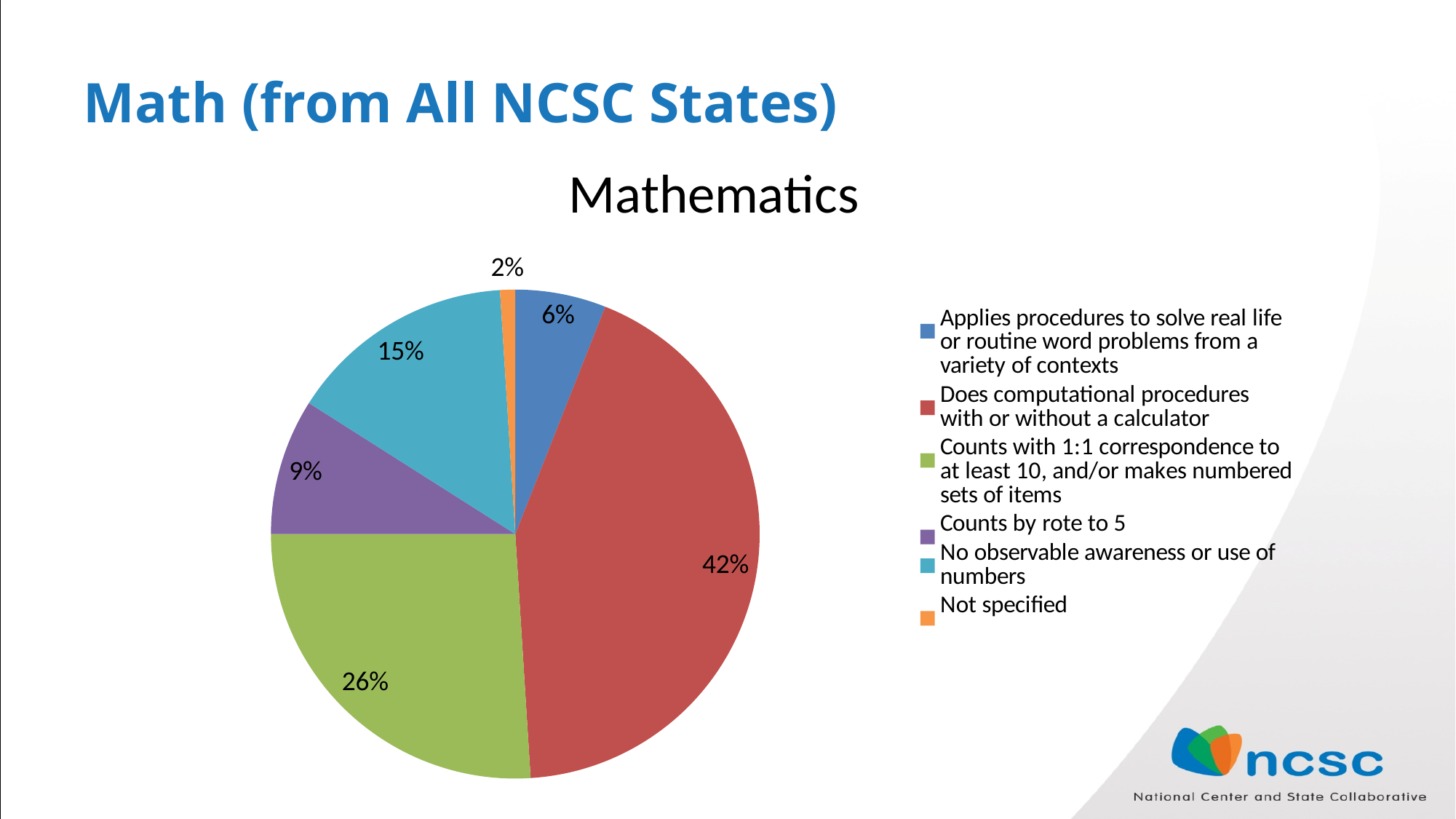
What percentage of the pie is 'Counts by rote to 5'? 9% What percentage of the pie is 'No observable awareness or use of numbers'? 15% What is the chart's title? Mathematics What percentage of the pie is 'Does computational procedures with or without a calculator'? 42% What is the difference in percentage points between 'Does computational procedures with or without a calculator' and 'Counts with 1:1 correspondence to at least 10, and/or makes numbered sets of items'? 16 percentage points Which category has the smallest share of the pie? Not specified What percentage of the pie is 'Not specified'? 2% How many categories does the legend list? 6 Which category has the largest share of the pie? Does computational procedures with or without a calculator What kind of chart is shown on the slide? pie chart Which is larger: the share for 'Counts by rote to 5' or the share for 'Applies procedures to solve real life or routine word problems from a variety of contexts'? Counts by rote to 5 What percentage of the pie is 'Counts with 1:1 correspondence to at least 10, and/or makes numbered sets of items'? 26%